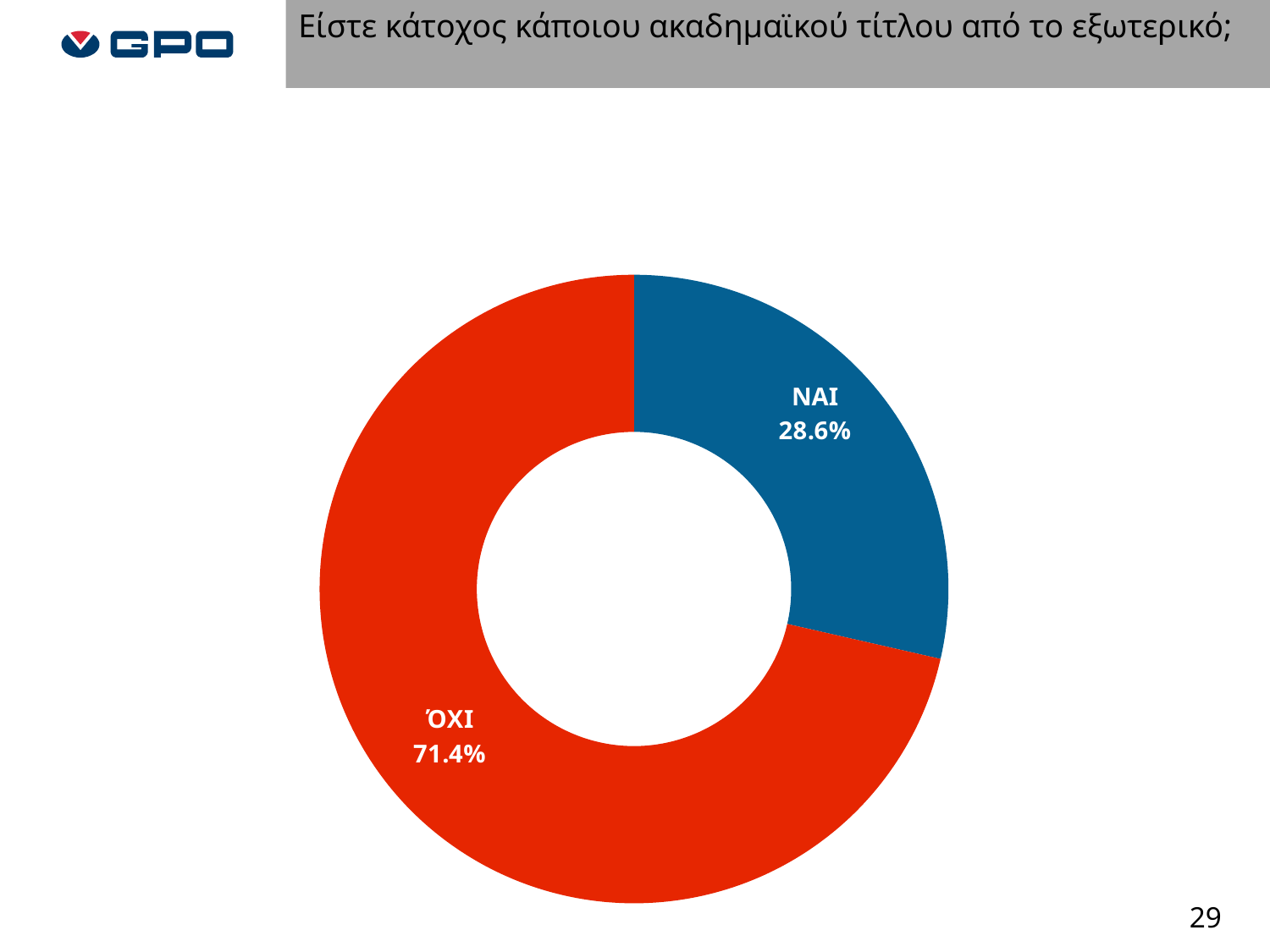
How many categories are shown in the chart? 2 What kind of chart is shown on the slide? Doughnut (pie) chart Which response has the largest share of the chart? ΌΧΙ What is the combined total of the ΝΑΙ and ΌΧΙ shares? 100% What is the difference in percentage points between ΌΧΙ and ΝΑΙ? 42.8 What colour is the ΌΧΙ segment of the chart? Red What percentage of respondents answered ΝΑΙ? 28.6% Which is larger, the share for ΝΑΙ or the share for ΌΧΙ? ΌΧΙ What percentage of respondents answered ΌΧΙ? 71.4% Which response has the smallest share of the chart? ΝΑΙ What colour is the ΝΑΙ segment of the chart? Blue